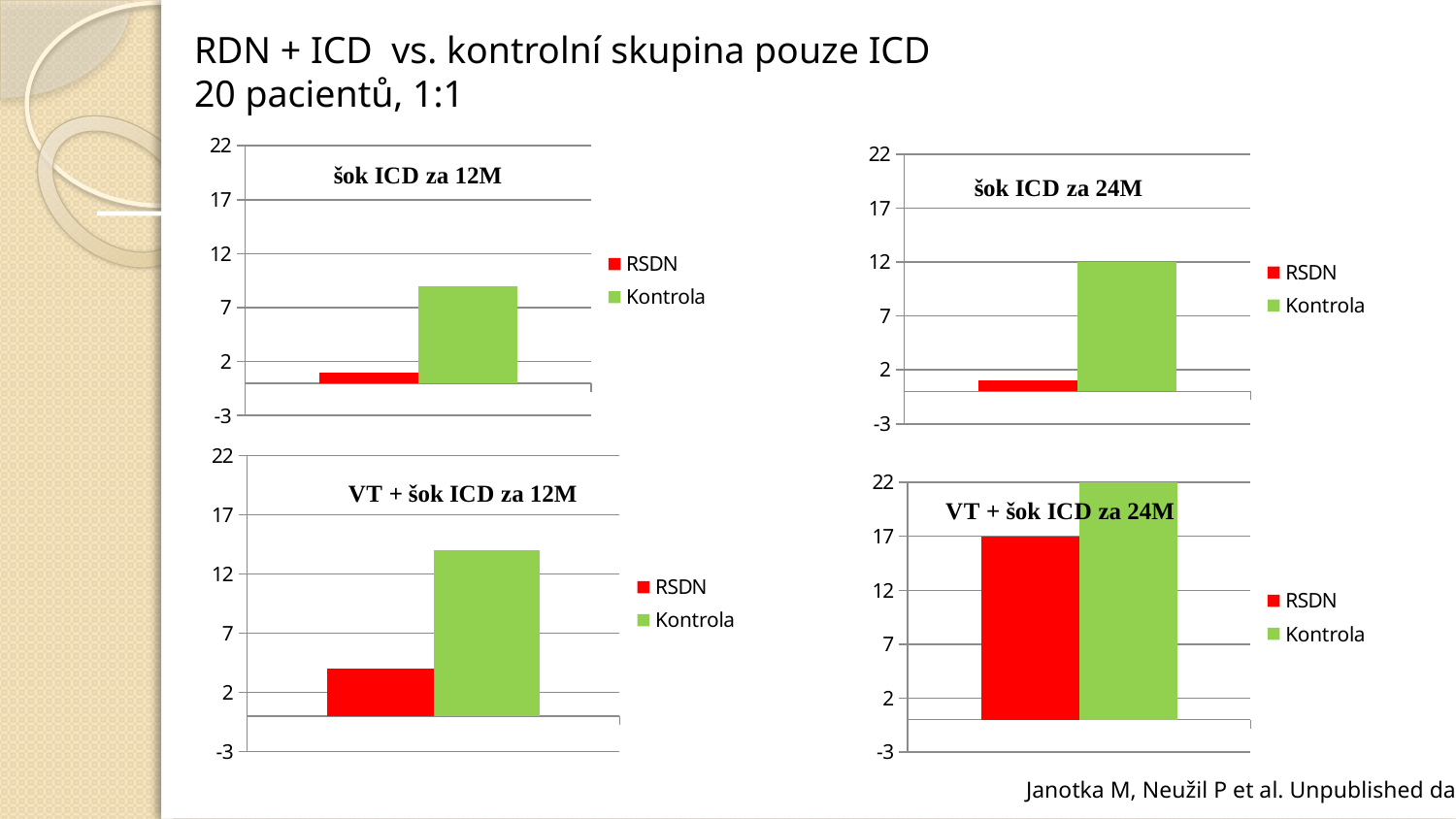
In the chart titled "šok ICD za 12M", which series has the higher value, RSDN or Kontrola? Kontrola In the chart titled "šok ICD za 24M", is the value for Kontrola greater or less than 7? greater In the chart titled "VT + šok ICD za 24M", what is the value for RSDN? 17 In the chart titled "šok ICD za 12M", is the value for RSDN greater or less than 2? less In the chart titled "VT + šok ICD za 24M", what is the value for Kontrola? 22 In the chart titled "VT + šok ICD za 24M", what is the difference between the Kontrola and RSDN values? 5 In the chart titled "šok ICD za 12M", is the value for Kontrola greater or less than 7? greater What type of chart is the chart titled "VT + šok ICD za 12M"? bar chart In the chart titled "šok ICD za 24M", which series has the lower value? RSDN How many series does the legend of the chart titled "šok ICD za 24M" list? 2